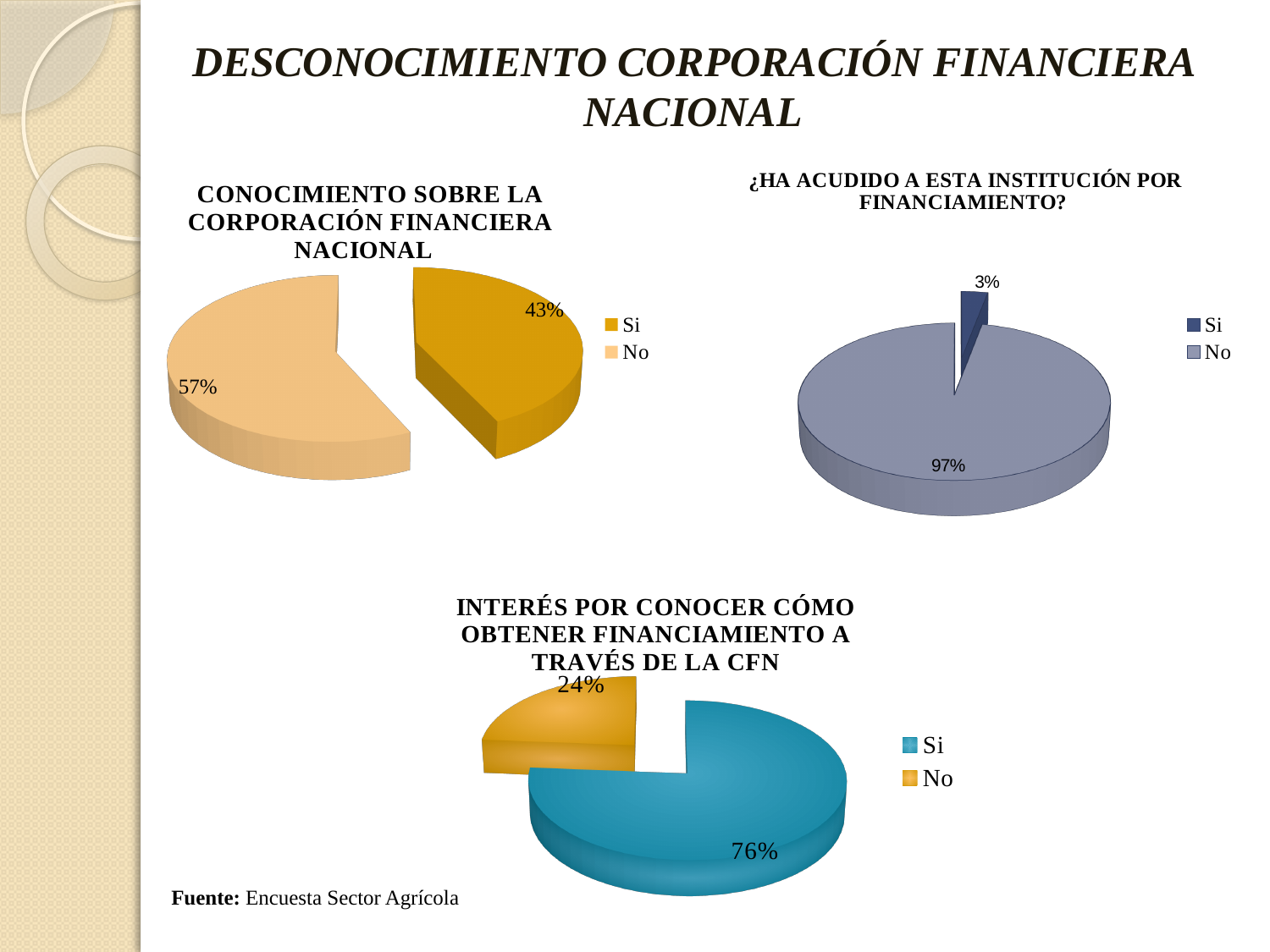
In the chart titled "¿HA ACUDIDO A ESTA INSTITUCIÓN POR FINANCIAMIENTO?", what percentage is shown for "Si"? 3% How many charts are shown on the slide? 3 In the chart titled "INTERÉS POR CONOCER CÓMO OBTENER FINANCIAMIENTO A TRAVÉS DE LA CFN", what percentage is shown for "No"? 24% In the chart titled "¿HA ACUDIDO A ESTA INSTITUCIÓN POR FINANCIAMIENTO?", what percentage is shown for "No"? 97% In the chart titled "¿HA ACUDIDO A ESTA INSTITUCIÓN POR FINANCIAMIENTO?", what is the difference between the "No" and "Si" shares? 94% In the chart titled "CONOCIMIENTO SOBRE LA CORPORACIÓN FINANCIERA NACIONAL", what percentage is shown for "No"? 57% In the chart titled "CONOCIMIENTO SOBRE LA CORPORACIÓN FINANCIERA NACIONAL", what percentage is shown for "Si"? 43% In the chart titled "INTERÉS POR CONOCER CÓMO OBTENER FINANCIAMIENTO A TRAVÉS DE LA CFN", what percentage is shown for "Si"? 76% In the chart titled "CONOCIMIENTO SOBRE LA CORPORACIÓN FINANCIERA NACIONAL", what is the difference between the "No" and "Si" shares? 14% In the chart titled "CONOCIMIENTO SOBRE LA CORPORACIÓN FINANCIERA NACIONAL", which category has the larger share? No What type of chart is the one titled "¿HA ACUDIDO A ESTA INSTITUCIÓN POR FINANCIAMIENTO?"? Pie chart In the chart titled "INTERÉS POR CONOCER CÓMO OBTENER FINANCIAMIENTO A TRAVÉS DE LA CFN", which category has the smaller share? No